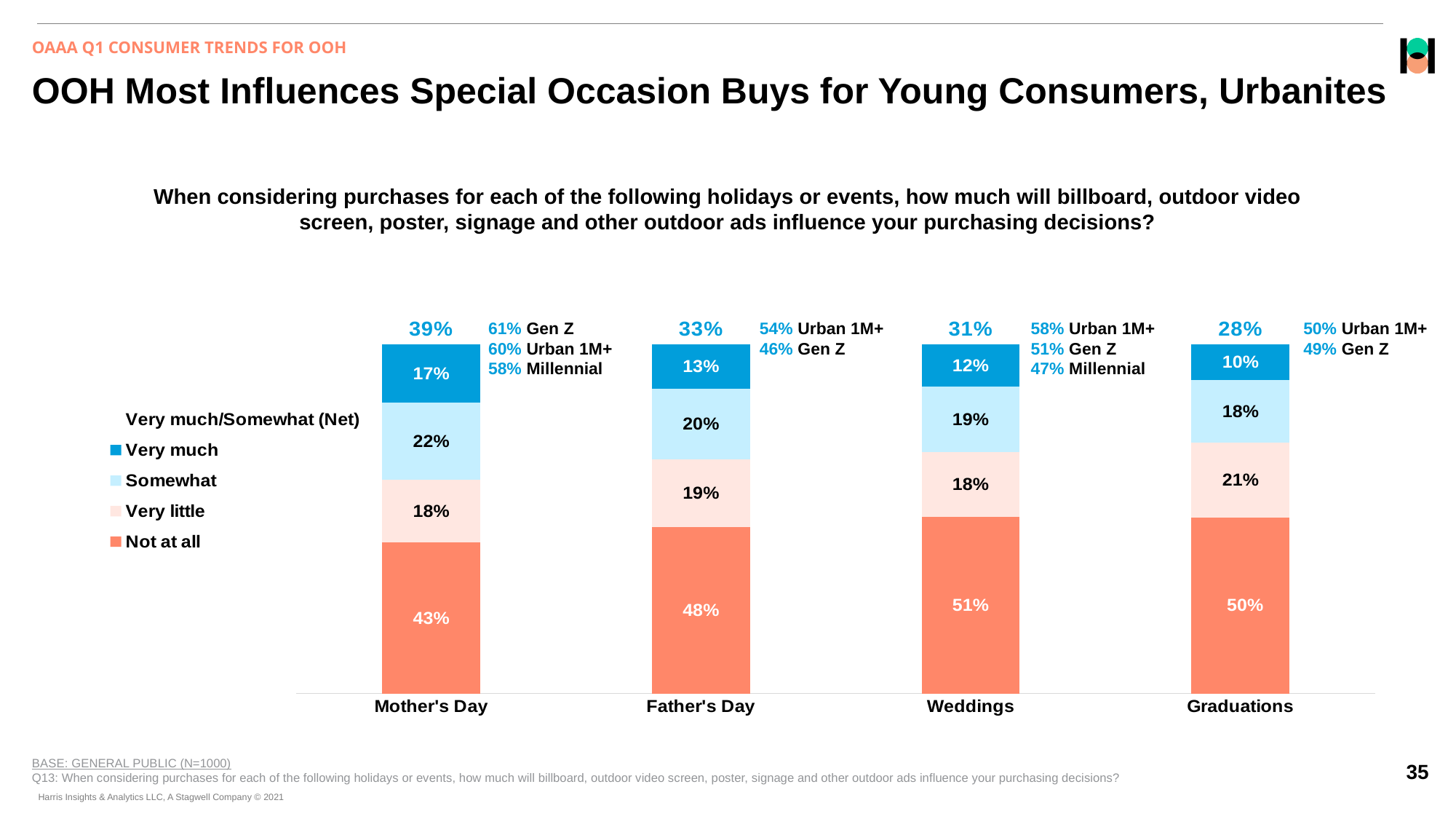
How many occasions are shown on the x axis of the chart? 4 What is the Very much/Somewhat (Net) value shown for Father's Day? 33% Which occasion has the lowest "Very much" value? Graduations How many series does the chart legend list? 5 What percentage of respondents said outdoor ads would influence their Mother's Day purchases "Not at all"? 43% What is the "Somewhat" value for Weddings? 19% What kind of chart is shown on the slide? Stacked bar chart Which occasion has the highest Very much/Somewhat (Net) value? Mother's Day What is the "Very much" value for Graduations? 10% What is the difference between the "Not at all" values for Weddings and Mother's Day? 8% Do the Very much/Somewhat (Net) values rise or fall from Mother's Day to Graduations? Fall Which is larger, the "Very little" value for Graduations or for Mother's Day? Graduations